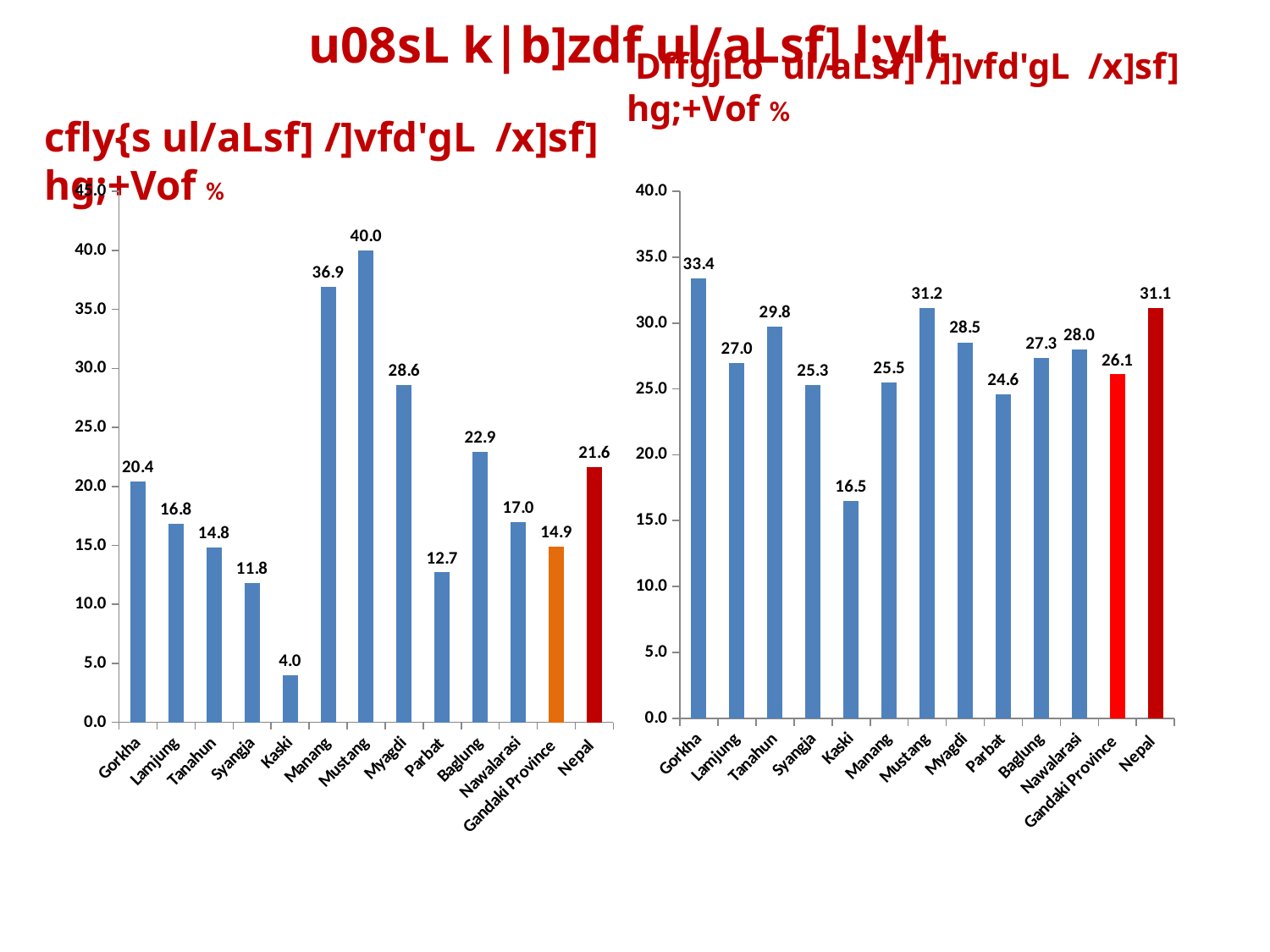
In the left chart, what colour is the bar for Gandaki Province? Orange In the right chart, what is the difference between the values for Nepal and Gandaki Province? 5.0 In the left chart, what is the value for Mustang? 40.0 In the left chart, what is the value for Gandaki Province? 14.9 In the right chart, what is the value for Nepal? 31.1 In the right chart, which category has the highest value? Gorkha How many categories are shown on the x axis of the left chart? 13 In the right chart, what is the value for Kaski? 16.5 What type of chart is the right chart? Bar chart In the left chart, which category has the lowest value? Kaski In the right chart, which is larger, the value for Tanahun or the value for Myagdi? Tanahun In the left chart, what is the difference between the values for Mustang and Manang? 3.1